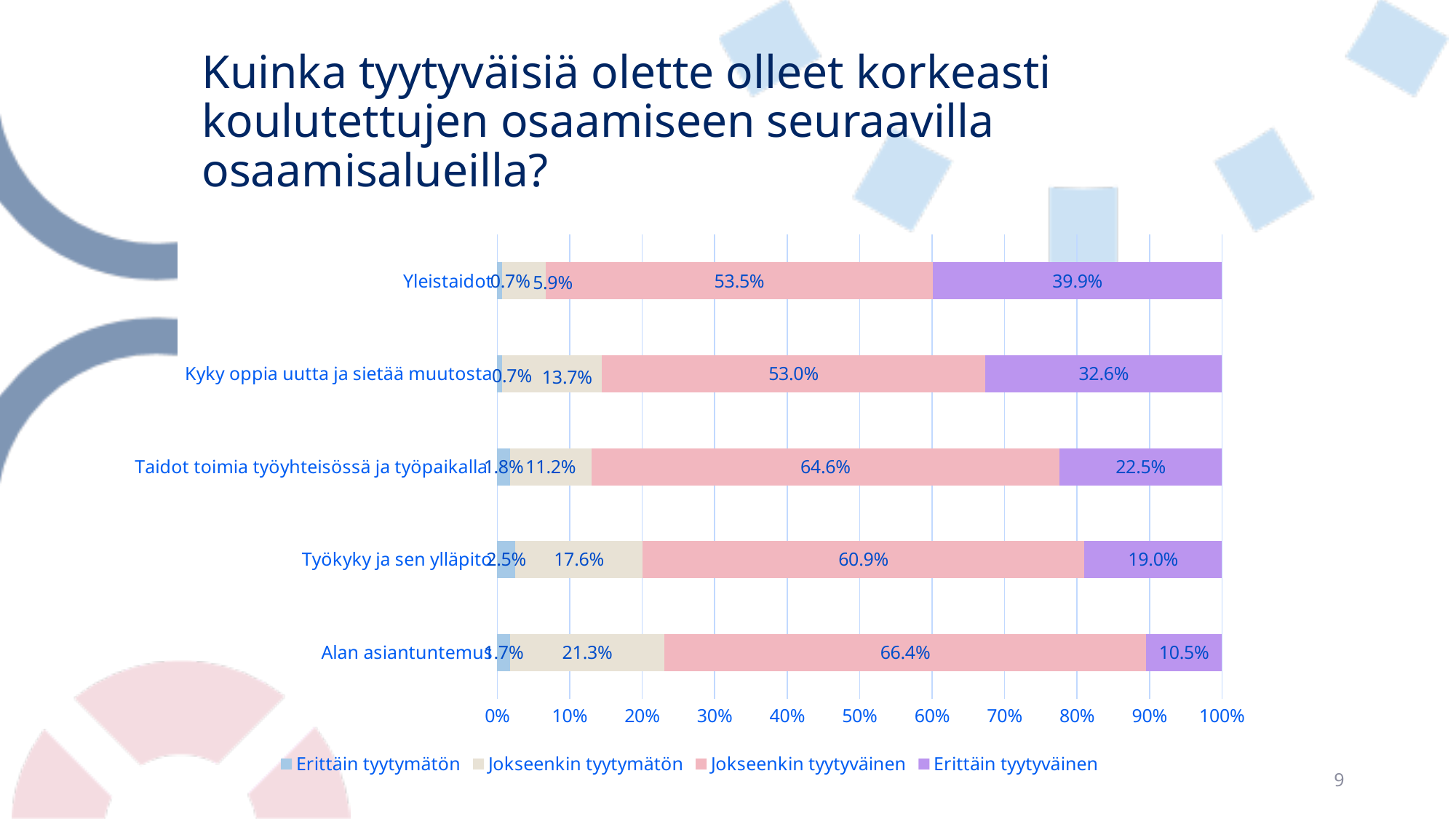
How many series does the legend list? 4 What kind of chart is shown on the slide? Stacked bar chart Which category has the highest 'Jokseenkin tyytymätön' share? Alan asiantuntemus What is the difference between the 'Jokseenkin tyytymätön' values for Alan asiantuntemus and Yleistaidot? 15.4 percentage points Which has a larger 'Jokseenkin tyytyväinen' share: Taidot toimia työyhteisössä ja työpaikalla or Työkyky ja sen ylläpito? Taidot toimia työyhteisössä ja työpaikalla What is the first entry in the chart legend? Erittäin tyytymätön What percentage of respondents were 'Jokseenkin tyytyväinen' with Alan asiantuntemus? 66.4% Which category has the highest 'Erittäin tyytyväinen' share? Yleistaidot Which category has the lowest 'Erittäin tyytyväinen' share? Alan asiantuntemus How many categories (osaamisalueet) are shown in the chart? 5 What is the 'Jokseenkin tyytymätön' value for Kyky oppia uutta ja sietää muutosta? 13.7% What is the 'Erittäin tyytyväinen' share for Yleistaidot? 39.9%